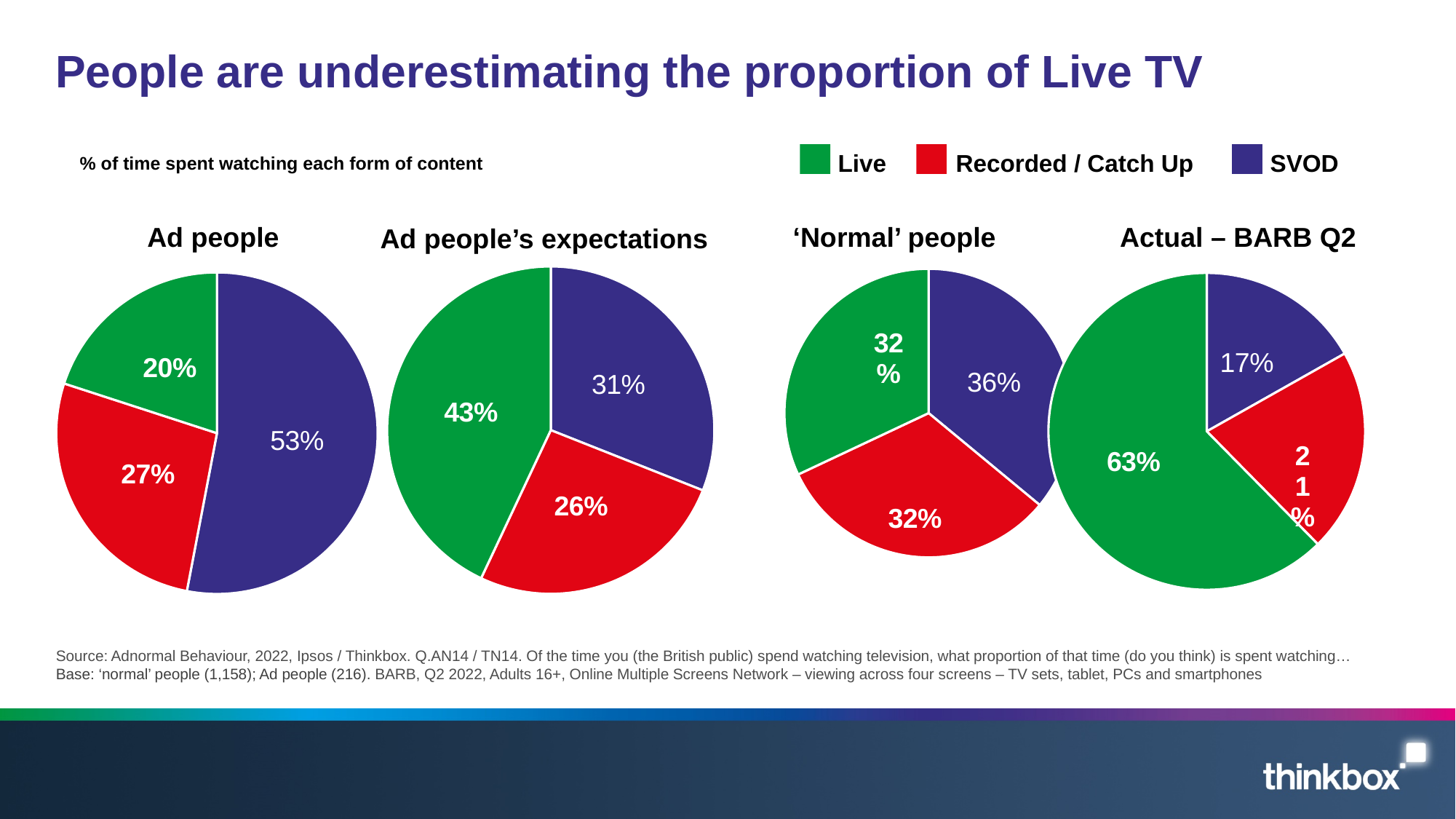
In the 'Actual – BARB Q2' pie chart, what percentage is shown for SVOD? 17% In the 'Ad people's expectations' pie chart, what percentage is shown for Live? 43% In the 'Ad people' pie chart, what percentage is shown for Live? 20% In the 'Normal' people pie chart, what percentage is shown for SVOD? 36% What is the difference between the Live share in the 'Actual – BARB Q2' pie chart and the Live share in the 'Ad people' pie chart? 43 percentage points In the 'Ad people' pie chart, which category has the smallest share? Live In the 'Ad people's expectations' pie chart, what percentage is shown for Recorded / Catch Up? 26% In the 'Actual – BARB Q2' pie chart, which category has the largest share? Live How many categories does the legend list? 3 In the 'Actual – BARB Q2' pie chart, what percentage is shown for Live? 63% In the 'Ad people's expectations' pie chart, which is larger: the SVOD share or the Recorded / Catch Up share? SVOD In the 'Ad people' pie chart, what percentage is shown for SVOD? 53%